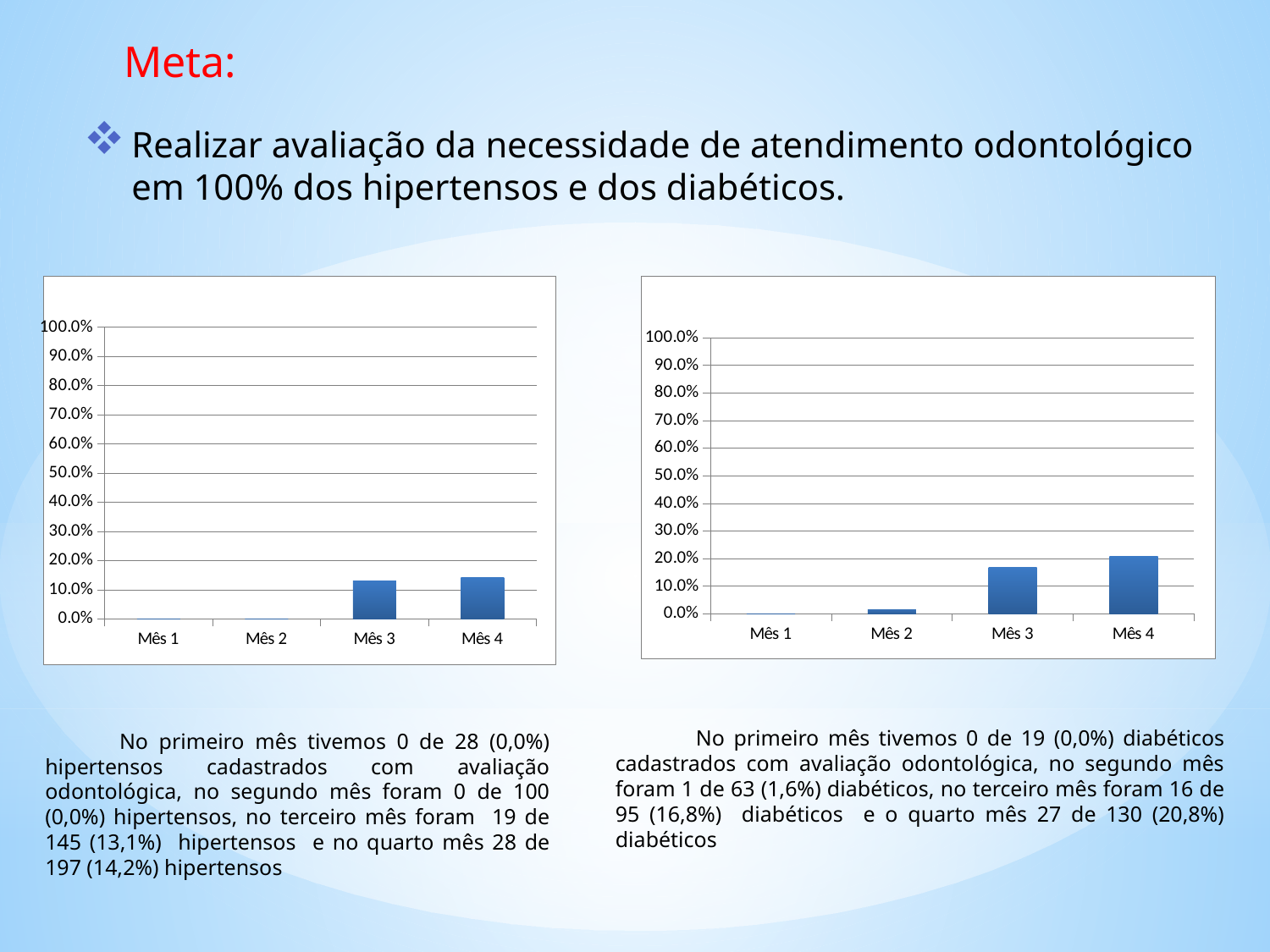
In the left chart, is the value for Mês 4 greater or less than 10.0%? greater What kind of chart is the left chart? bar chart How many categories are shown on the x axis of the right chart? 4 How many categories are shown on the x axis of the left chart? 4 In the left chart, is the value for Mês 3 greater or less than 20.0%? less In the right chart, do the values rise or fall from Mês 1 to Mês 4? rise What kind of chart is the right chart? bar chart In the right chart, which is larger, the value for Mês 2 or the value for Mês 3? Mês 3 In the right chart, is the value for Mês 3 greater or less than 20.0%? less In the left chart, what is the value for Mês 1? 0.0% In the right chart, which month has the highest value? Mês 4 What is the highest value shown on the y axis of the left chart? 100.0%